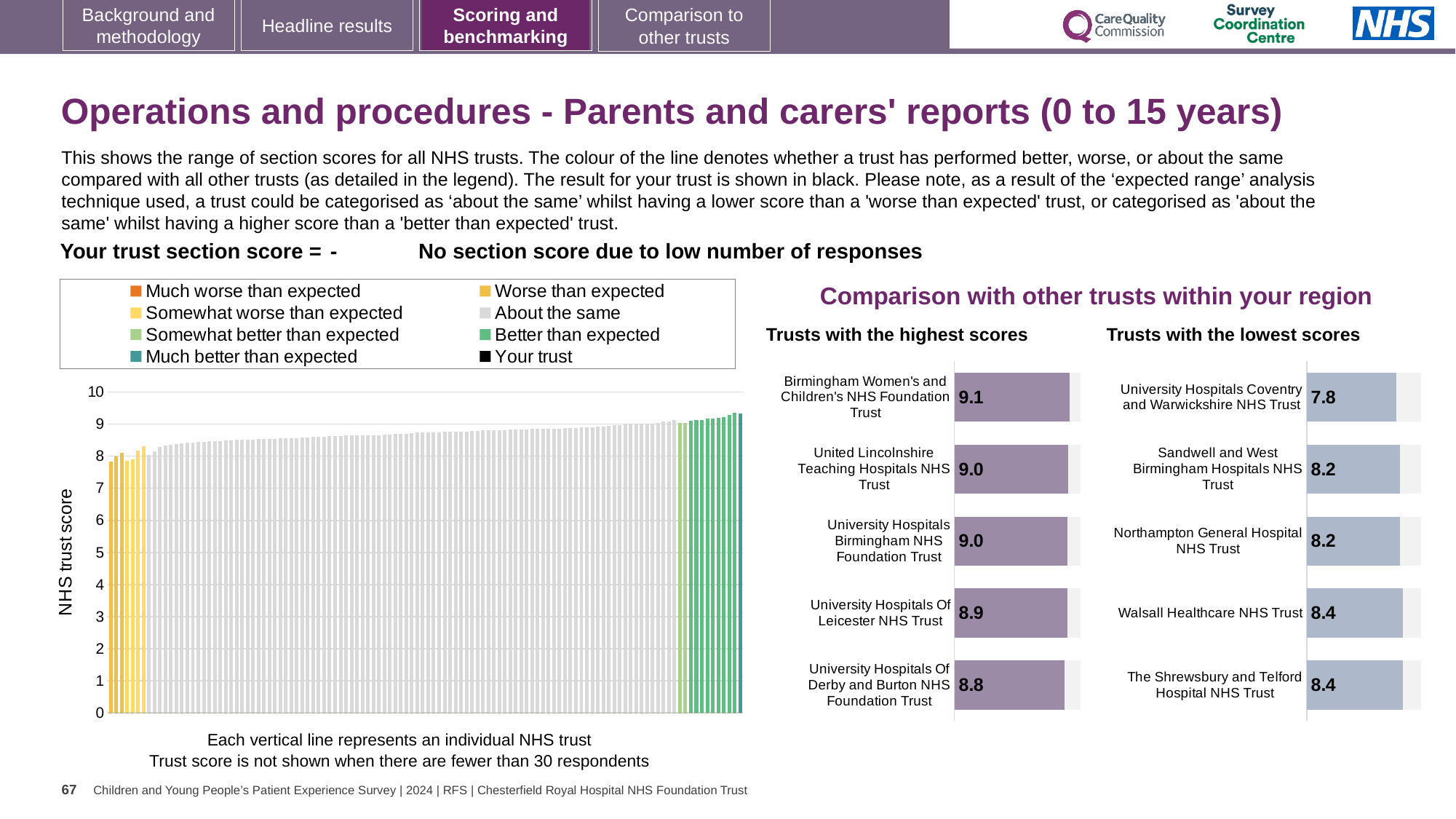
Which has the higher score: University Hospitals Of Leicester NHS Trust in the highest scores chart or Sandwell and West Birmingham Hospitals NHS Trust in the lowest scores chart? University Hospitals Of Leicester NHS Trust How many entries does the legend of the main NHS trust score chart list? 8 In the 'Trusts with the highest scores' chart, what is the score for Birmingham Women's and Children's NHS Foundation Trust? 9.1 In the 'Trusts with the lowest scores' chart, what is the difference between the scores of Walsall Healthcare NHS Trust and University Hospitals Coventry and Warwickshire NHS Trust? 0.6 In the 'Trusts with the highest scores' chart, what is the score for University Hospitals Of Leicester NHS Trust? 8.9 In the 'Trusts with the lowest scores' chart, what is the score for Walsall Healthcare NHS Trust? 8.4 In the 'Trusts with the lowest scores' chart, which trust has the lowest score? University Hospitals Coventry and Warwickshire NHS Trust In the 'Trusts with the lowest scores' chart, what is the score for University Hospitals Coventry and Warwickshire NHS Trust? 7.8 In the main NHS trust score chart, do the values rise or fall from left to right? rise In the 'Trusts with the highest scores' chart, which trust has the highest score? Birmingham Women's and Children's NHS Foundation Trust In the 'Trusts with the highest scores' chart, what is the difference between the scores of Birmingham Women's and Children's NHS Foundation Trust and University Hospitals Of Derby and Burton NHS Foundation Trust? 0.3 How many trusts are listed in the 'Trusts with the highest scores' chart? 5